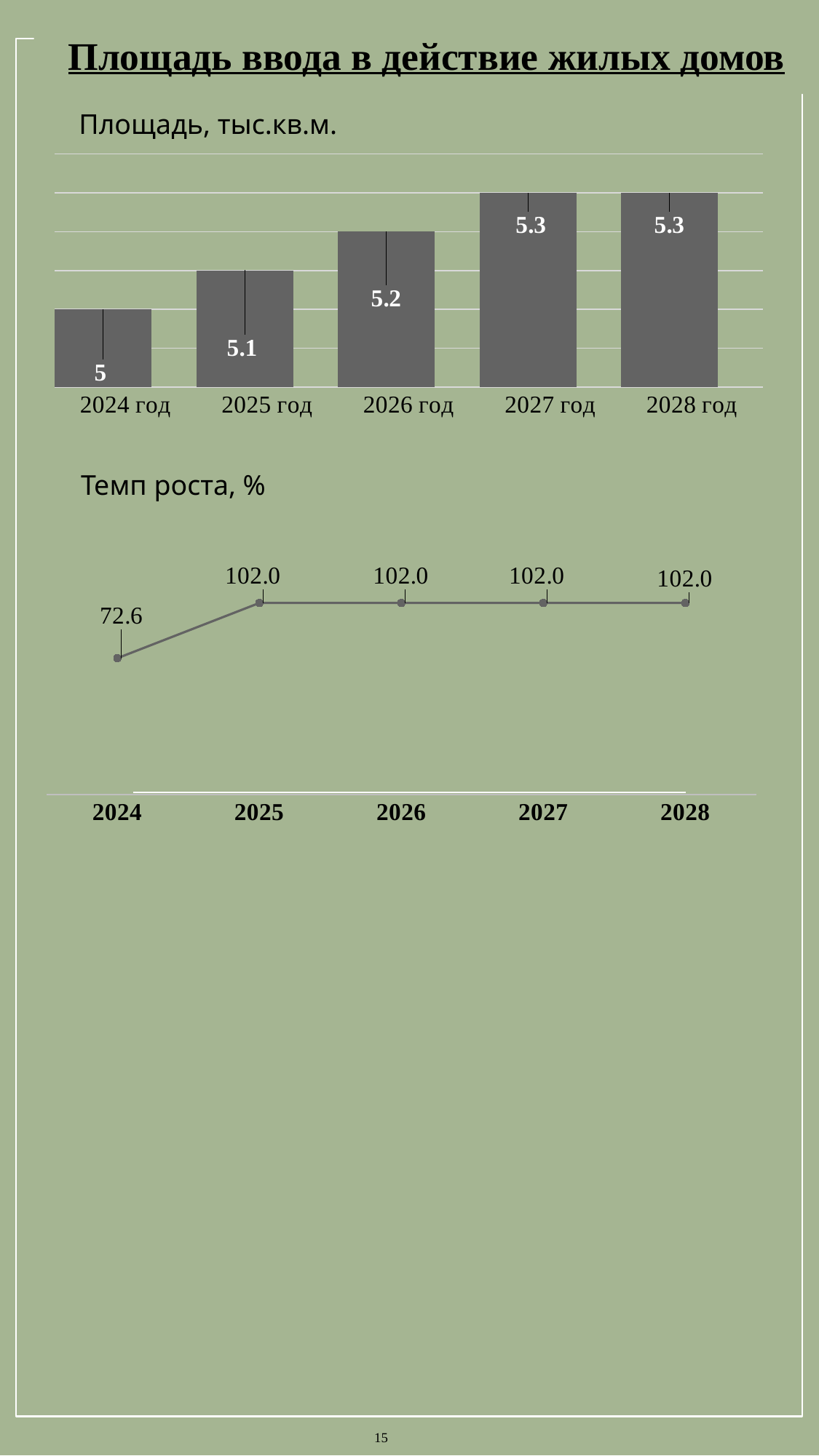
In the 'Темп роста, %' chart, what is the value for 2024? 72.6 What kind of chart is the 'Площадь, тыс.кв.м.' chart? bar chart How many bars are in the 'Площадь, тыс.кв.м.' chart? 5 In the 'Площадь, тыс.кв.м.' chart, what is the value for 2024 год? 5 In the 'Площадь, тыс.кв.м.' chart, do the values rise or fall from 2024 год to 2027 год? rise In the 'Площадь, тыс.кв.м.' chart, what is the value for 2026 год? 5.2 In the 'Темп роста, %' chart, what is the difference between the values for 2025 and 2024? 29.4 What kind of chart is the 'Темп роста, %' chart? line chart In the 'Темп роста, %' chart, what is the value for 2027? 102.0 In the 'Площадь, тыс.кв.м.' chart, what is the difference between the values for 2027 год and 2025 год? 0.2 In the 'Площадь, тыс.кв.м.' chart, which is larger, the value for 2025 год or the value for 2026 год? 2026 год In the 'Площадь, тыс.кв.м.' chart, which year has the lowest value? 2024 год